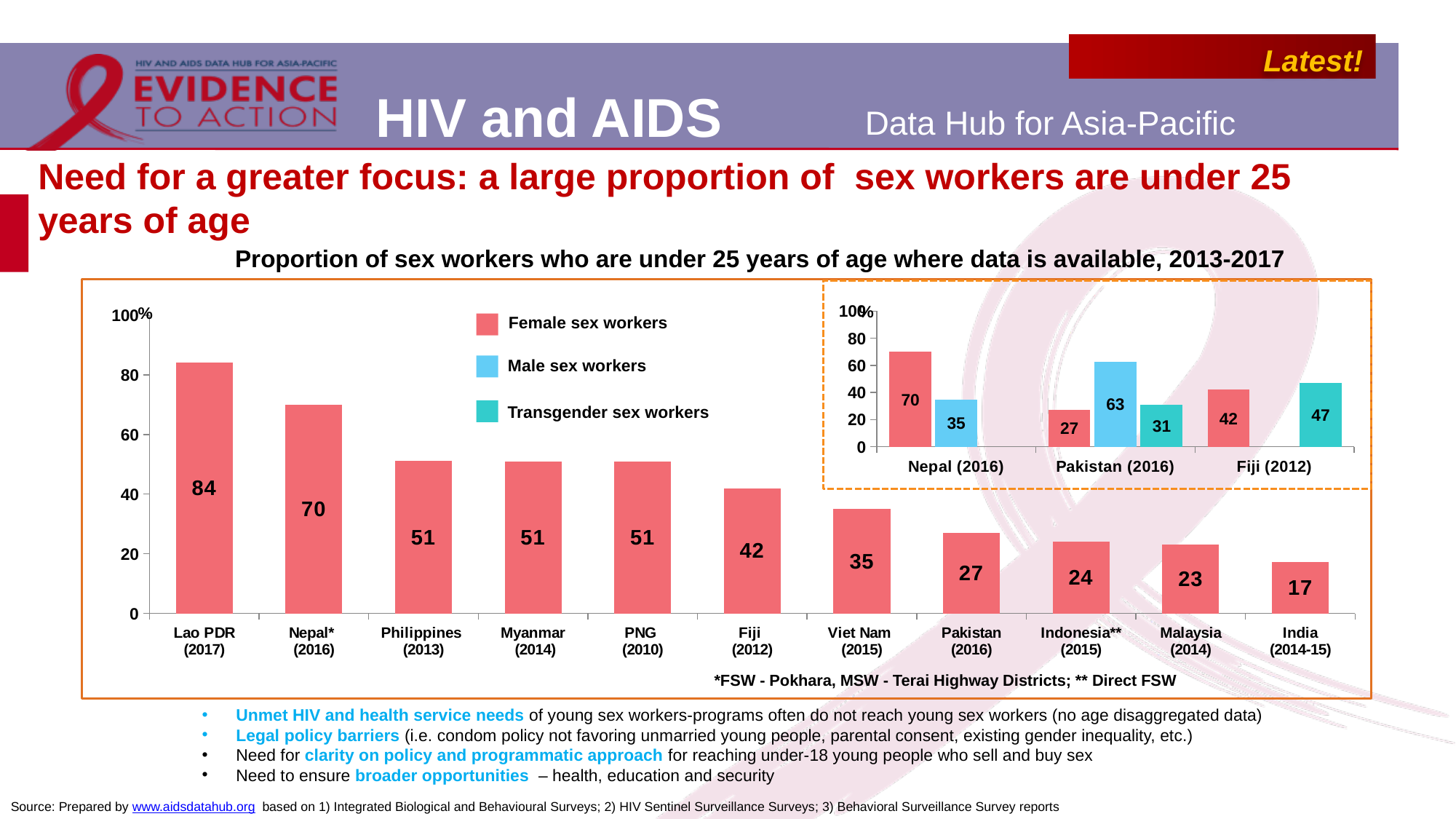
In the main bar chart, what is the difference between the values for Lao PDR (2017) and India (2014-15)? 67 In the inset chart, what is the value for male sex workers in Pakistan (2016)? 63 In the inset chart, what is the value for transgender sex workers in Fiji (2012)? 47 How many series does the legend list? 3 In the main bar chart, do the values generally rise or fall from left to right? Fall In the main bar chart, which country has the lowest proportion of sex workers under 25? India (2014-15) In the main bar chart, what is the value for Lao PDR (2017)? 84 In the main bar chart, how many countries are shown? 11 In the inset chart, what is the difference between male and female sex workers in Nepal (2016)? 35 In the main bar chart, which country has the highest value? Lao PDR (2017) What type of chart is the main chart on the slide? Bar chart In the main bar chart, is the value for Viet Nam (2015) larger or smaller than the value for Pakistan (2016)? larger